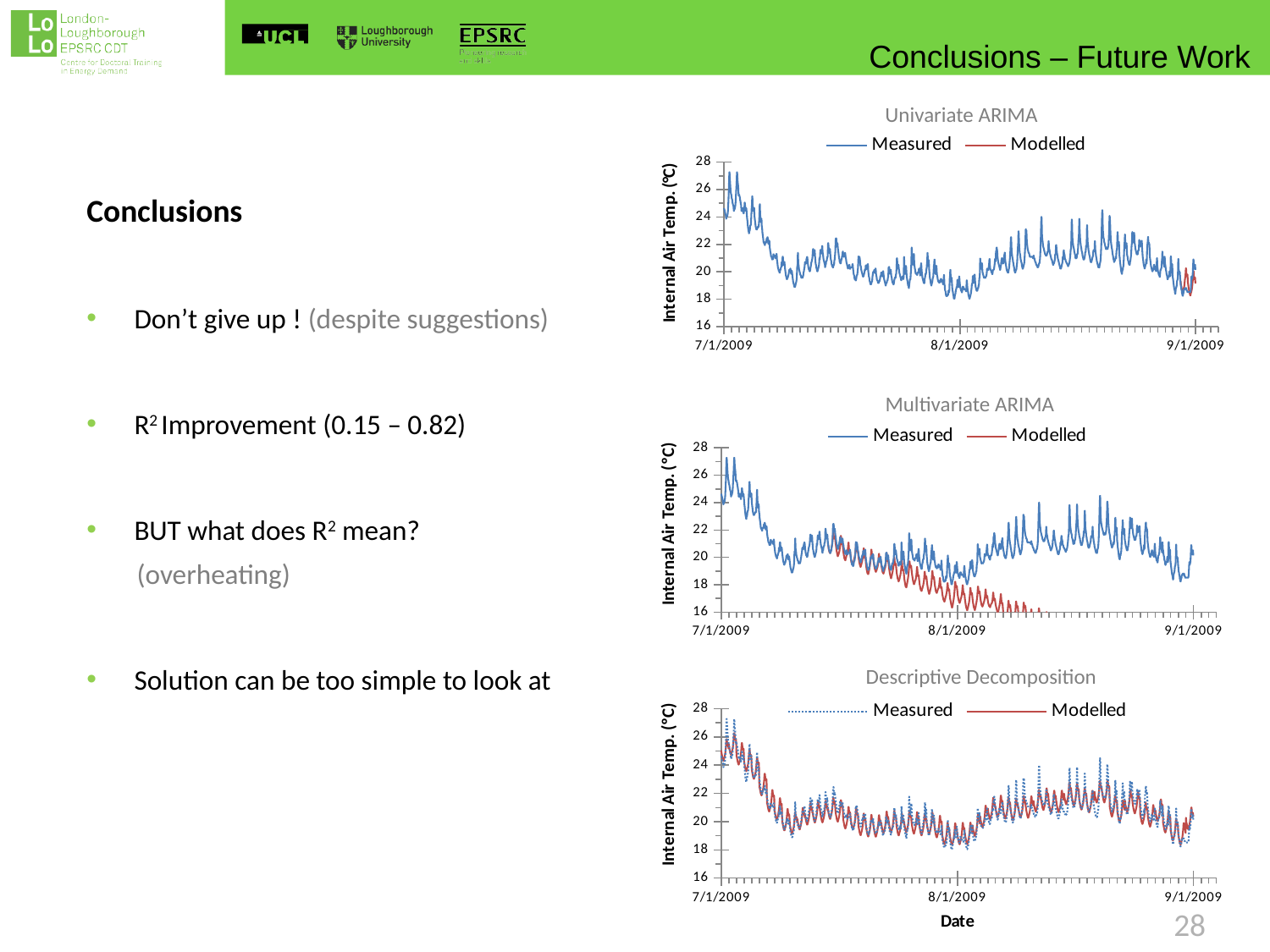
What kind of chart is the 'Univariate ARIMA' chart? line chart How many date labels are shown on the x axis of the 'Descriptive Decomposition' chart? 3 In the 'Multivariate ARIMA' chart, does the Modelled line rise or fall over time? fall In the 'Univariate ARIMA' chart, is the Measured value at 8/1/2009 greater or less than 22? less In the 'Descriptive Decomposition' chart, is the Measured value at 7/1/2009 greater or less than 22? greater How many series does the legend of the 'Multivariate ARIMA' chart list? 2 What are the two series named in the legend of the 'Descriptive Decomposition' chart? Measured and Modelled How many charts are shown on the slide? 3 In the 'Multivariate ARIMA' chart, at 8/1/2009, which series is higher, Measured or Modelled? Measured In the 'Univariate ARIMA' chart, is the Measured value at 7/1/2009 greater or less than 24? greater What is the y-axis label on the 'Univariate ARIMA' chart? Internal Air Temp. (°C)